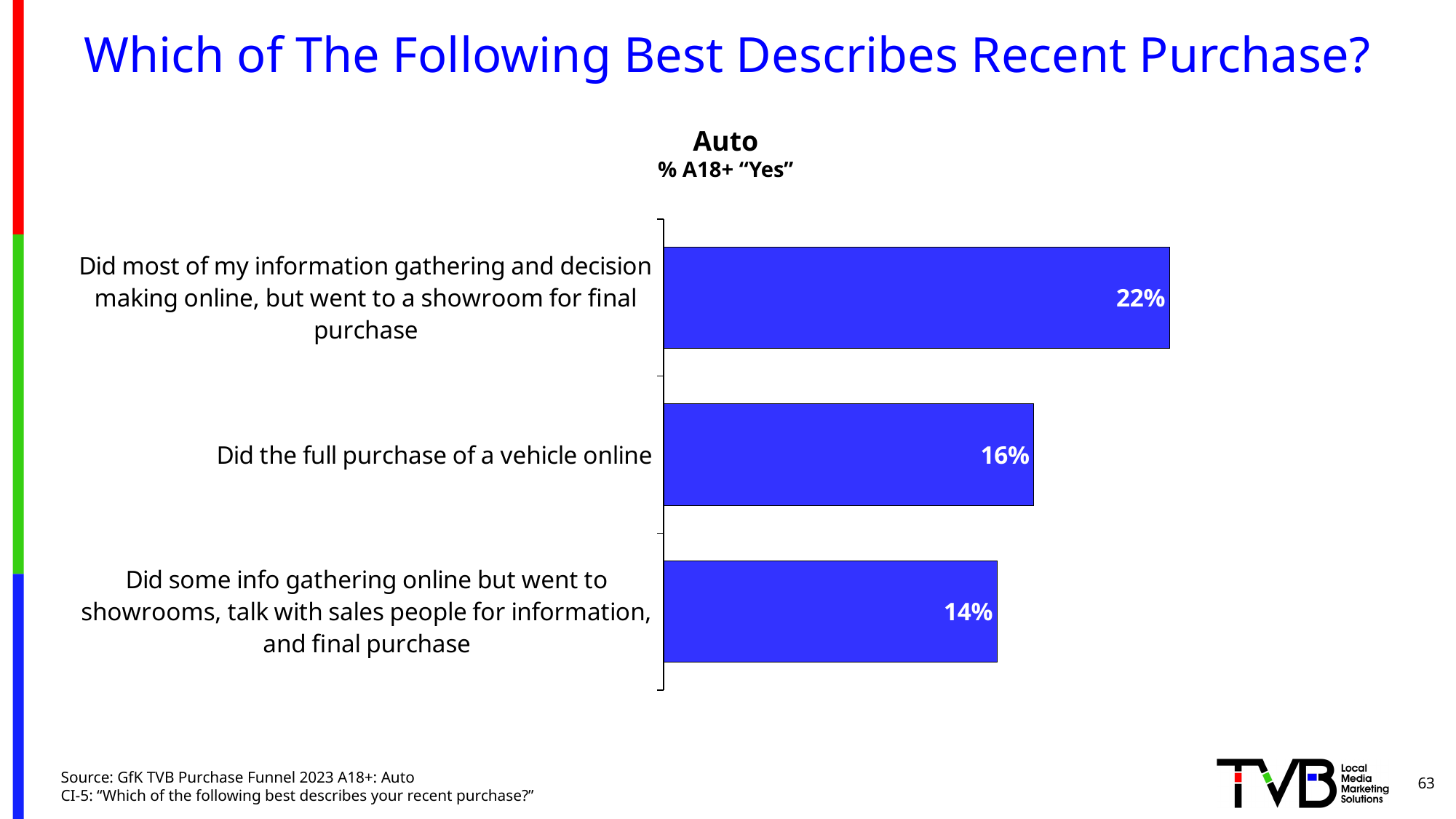
What is the difference in percentage points between 'Did the full purchase of a vehicle online' and 'Did some info gathering online but went to showrooms, talk with sales people for information, and final purchase'? 2 Which purchase description has the lowest percentage? Did some info gathering online but went to showrooms, talk with sales people for information, and final purchase What percentage of A18+ said they did the full purchase of a vehicle online? 16% Which is larger: the percentage for 'Did the full purchase of a vehicle online' or for 'Did some info gathering online but went to showrooms, talk with sales people for information, and final purchase'? Did the full purchase of a vehicle online What percentage of A18+ said they did some info gathering online but went to showrooms, talked with sales people for information, and final purchase? 14% What is the subtitle shown under the chart title? % A18+ "Yes" What percentage of A18+ said they did most of their information gathering and decision making online, but went to a showroom for final purchase? 22% What is the difference in percentage points between the highest and lowest bars? 8 How many purchase descriptions are shown in the chart? 3 What is the title of the chart? Auto What type of chart is shown on the slide? Bar chart Which purchase description has the highest percentage? Did most of my information gathering and decision making online, but went to a showroom for final purchase